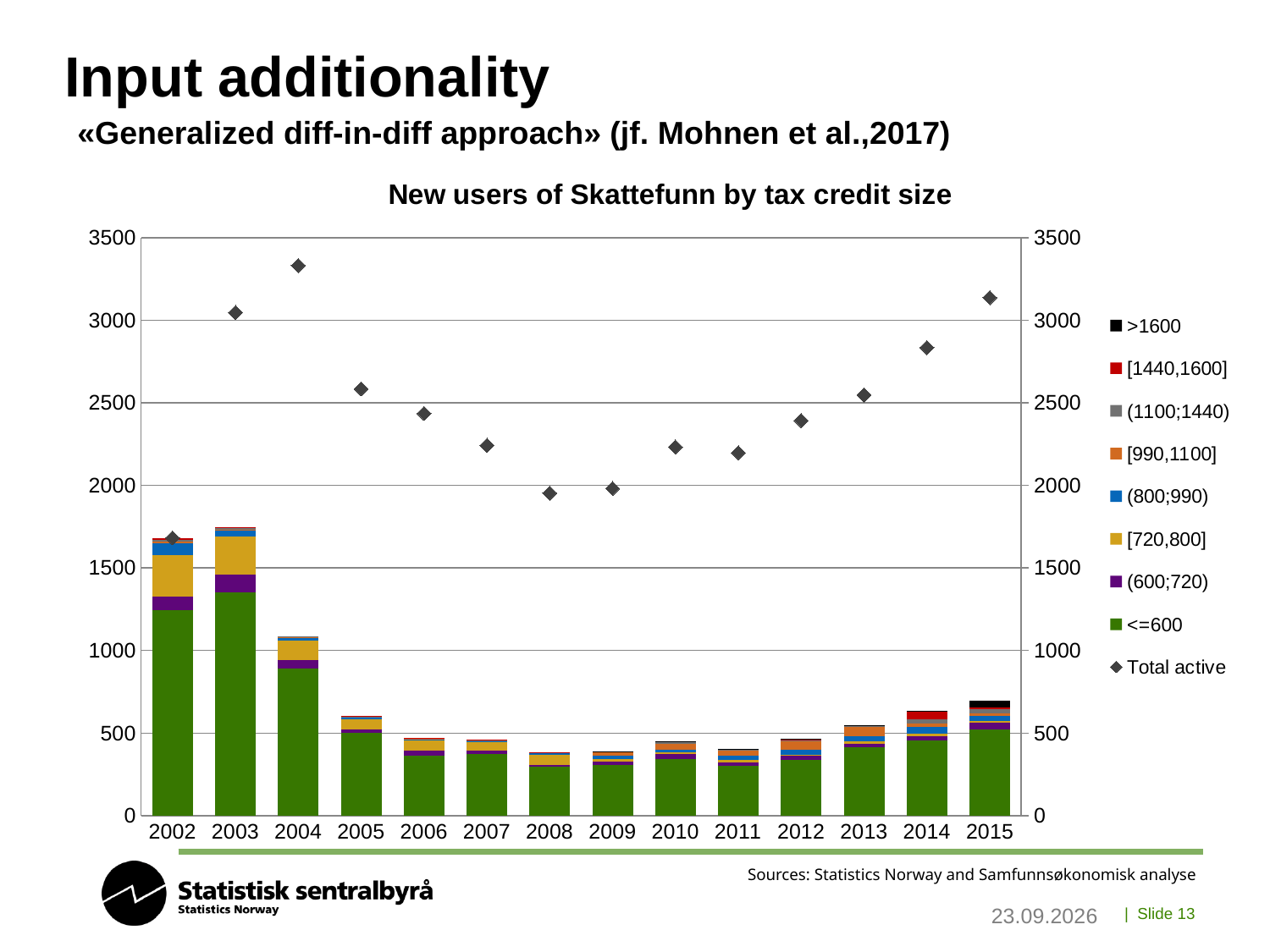
Is the Total active value for 2004 greater or less than 3000? greater Is the total height of the stacked bar for 2002 greater or less than 1500? greater How many years are shown on the x axis of the chart? 14 Which is larger, the Total active value for 2013 or for 2014? 2014 Which series is plotted with diamond markers instead of bars? Total active Which year has the tallest stacked bar of new users? 2003 In which year is the Total active value highest? 2004 What kind of chart is used to show the tax credit size categories? Stacked bar chart Is the Total active value for 2008 greater or less than 2000? less How many series does the legend list? 9 Does the Total active value rise or fall from 2004 to 2008? fall What is the title of the chart? New users of Skattefunn by tax credit size